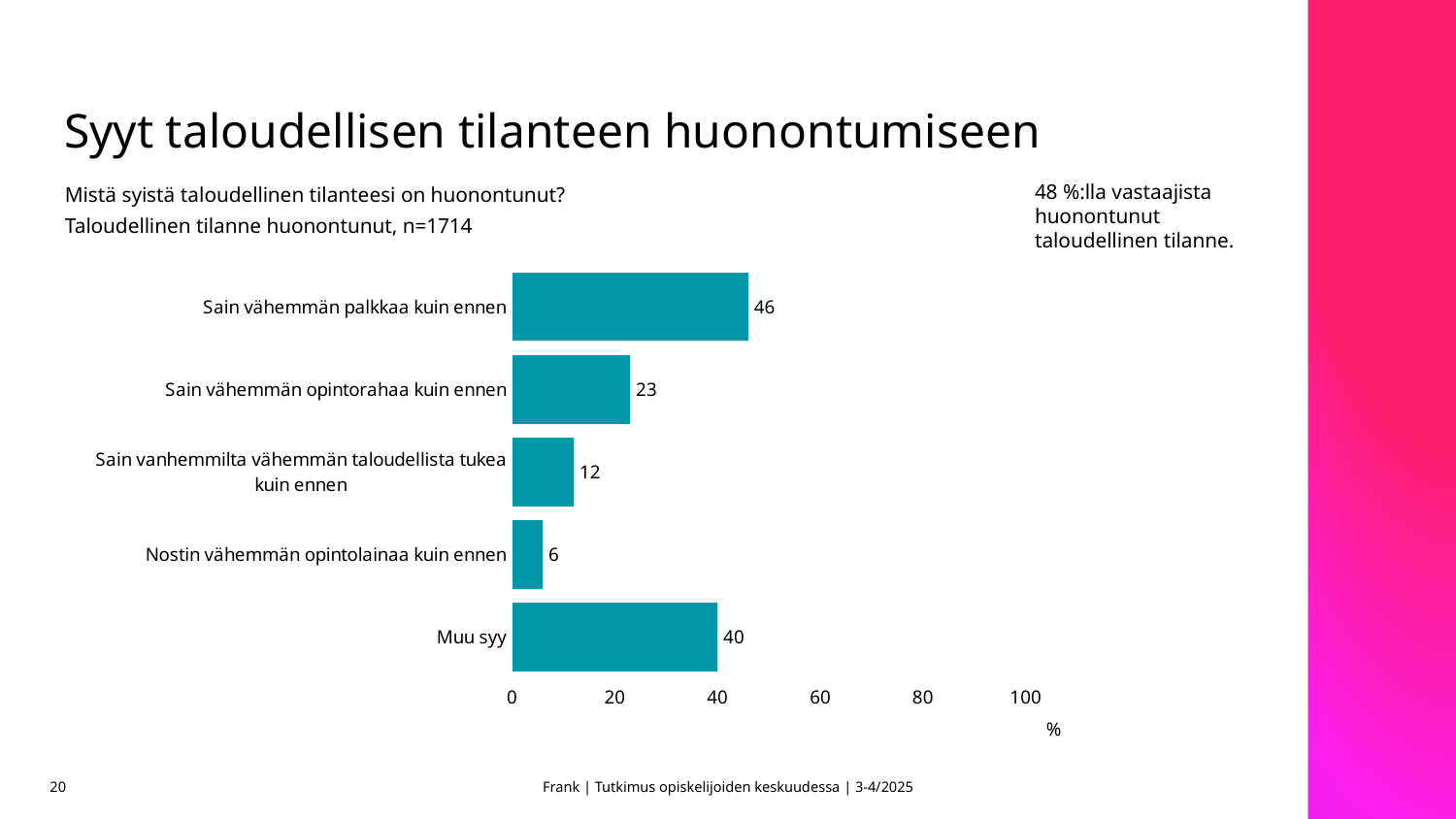
What is the value for "Nostin vähemmän opintolainaa kuin ennen"? 6 What is the value for "Sain vähemmän opintorahaa kuin ennen"? 23 Is the value for "Sain vähemmän palkkaa kuin ennen" greater or less than 60? less What kind of chart is shown on the slide? Bar chart What is the difference between the values for "Sain vähemmän palkkaa kuin ennen" and "Muu syy"? 6 Which category has the highest value? Sain vähemmän palkkaa kuin ennen What is the sample size (n) stated in the chart subtitle? n=1714 How many categories are shown in the chart? 5 What is the value for "Muu syy"? 40 Which category has the lowest value? Nostin vähemmän opintolainaa kuin ennen Which is larger: the value for "Sain vähemmän opintorahaa kuin ennen" or "Sain vanhemmilta vähemmän taloudellista tukea kuin ennen"? Sain vähemmän opintorahaa kuin ennen What is the value for "Sain vähemmän palkkaa kuin ennen"? 46